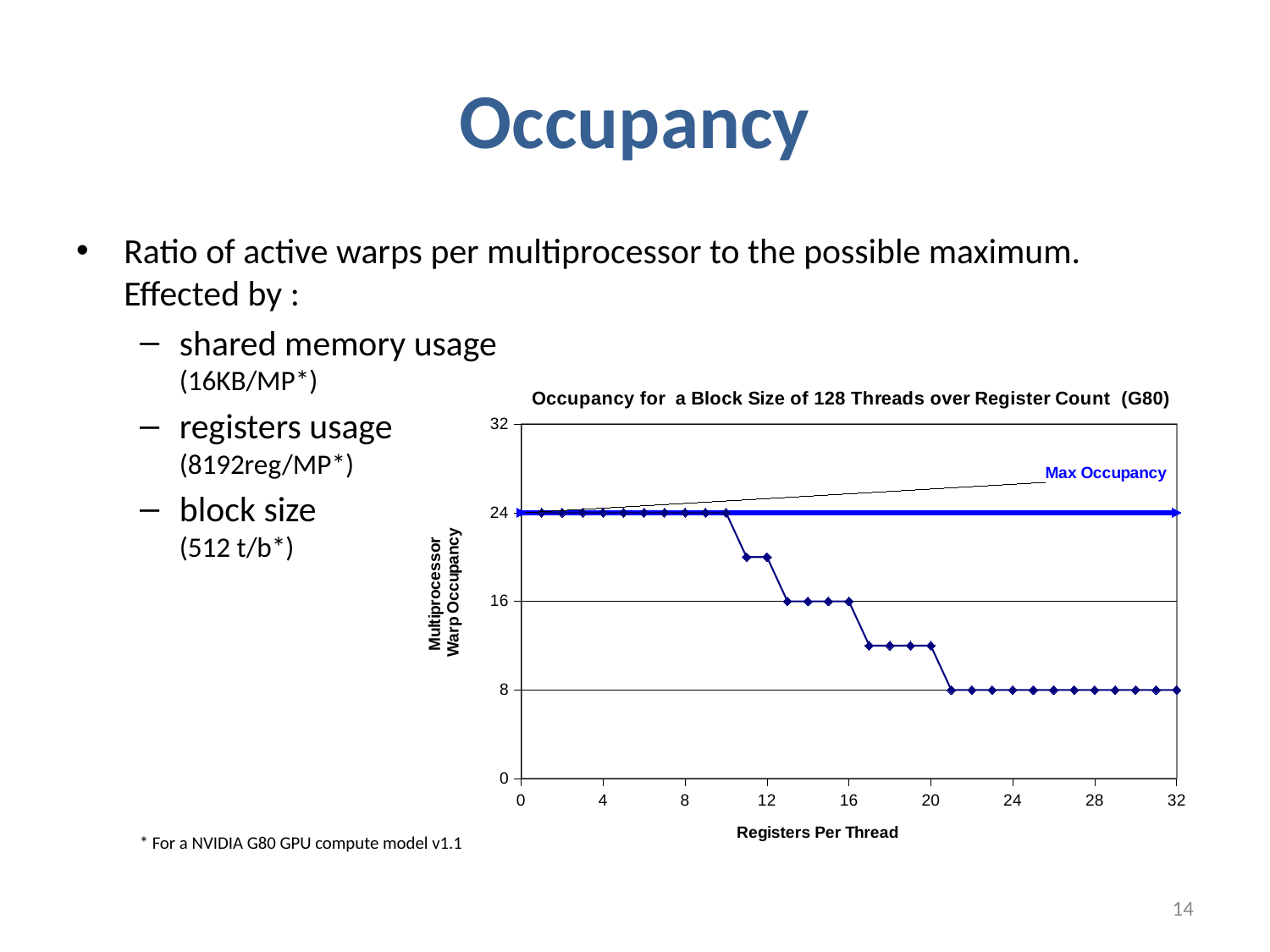
What is the Multiprocessor Warp Occupancy at 16 registers per thread? 16 What is the title of the chart? Occupancy for a Block Size of 128 Threads over Register Count (G80) What is the difference in Multiprocessor Warp Occupancy between 8 registers per thread and 32 registers per thread? 16 What is the label of the x axis of the chart? Registers Per Thread Is the Multiprocessor Warp Occupancy at 20 registers per thread greater or less than 16? less At what occupancy value is the Max Occupancy line drawn? 24 Does the warp occupancy rise or fall as registers per thread increase along the x axis? fall What is the Multiprocessor Warp Occupancy at 32 registers per thread? 8 What kind of chart is shown on the slide? line chart Is the Multiprocessor Warp Occupancy at 12 registers per thread greater or less than 16? greater What is the Multiprocessor Warp Occupancy at 24 registers per thread? 8 What is the Multiprocessor Warp Occupancy at 8 registers per thread? 24